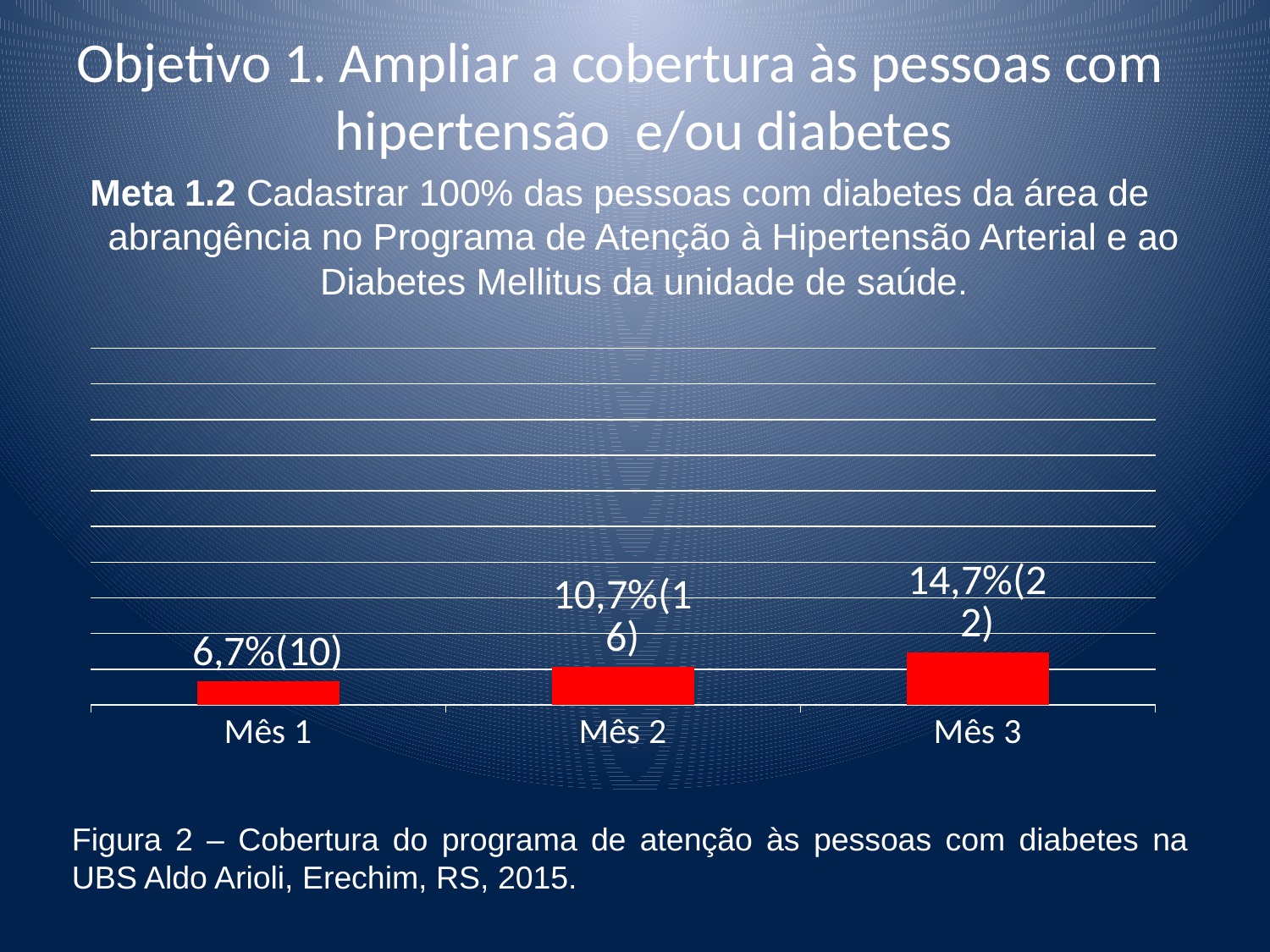
What is the value shown for Mês 2? 10,7%(16) What is the value shown for Mês 3? 14,7%(22) What is the value shown for Mês 1? 6,7%(10) Do the values rise or fall from Mês 1 to Mês 3? Rise What colour are the bars in the chart? Red How many months (categories) are shown on the x axis? 3 Which month has the lowest coverage? Mês 1 How many more people are counted in Mês 2 than in Mês 1 (using the numbers in parentheses)? 6 How many more people are counted in Mês 3 than in Mês 1 (using the numbers in parentheses)? 12 Which is larger, the value for Mês 2 or the value for Mês 3? Mês 3 Which month has the highest coverage? Mês 3 What kind of chart is shown on the slide? Bar chart